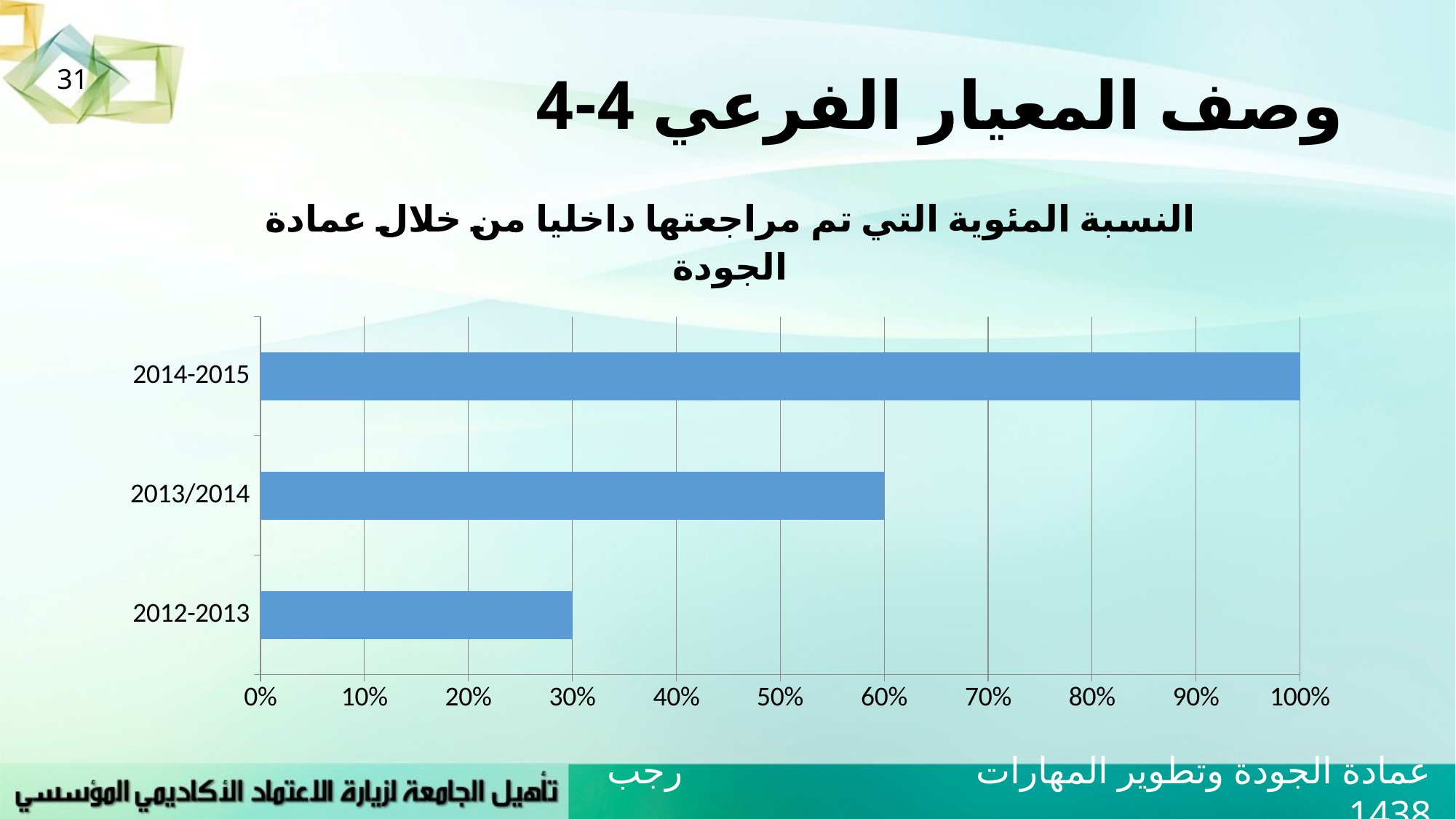
What is the value for 2013/2014? 60% What is the difference between the values for 2013/2014 and 2012-2013? 30% Which is larger, the value for 2013/2014 or the value for 2012-2013? 2013/2014 Which category has the highest value? 2014-2015 What is the difference between the values for 2014-2015 and 2013/2014? 40% Is the value for 2013/2014 greater or less than 50%? greater Which category has the lowest value? 2012-2013 What is the title of the chart? النسبة المئوية التي تم مراجعتها داخليا من خلال عمادة الجودة How many categories (academic years) are plotted in the chart? 3 What kind of chart is shown on the slide? bar chart What is the value for 2014-2015? 100% What is the value for 2012-2013? 30%